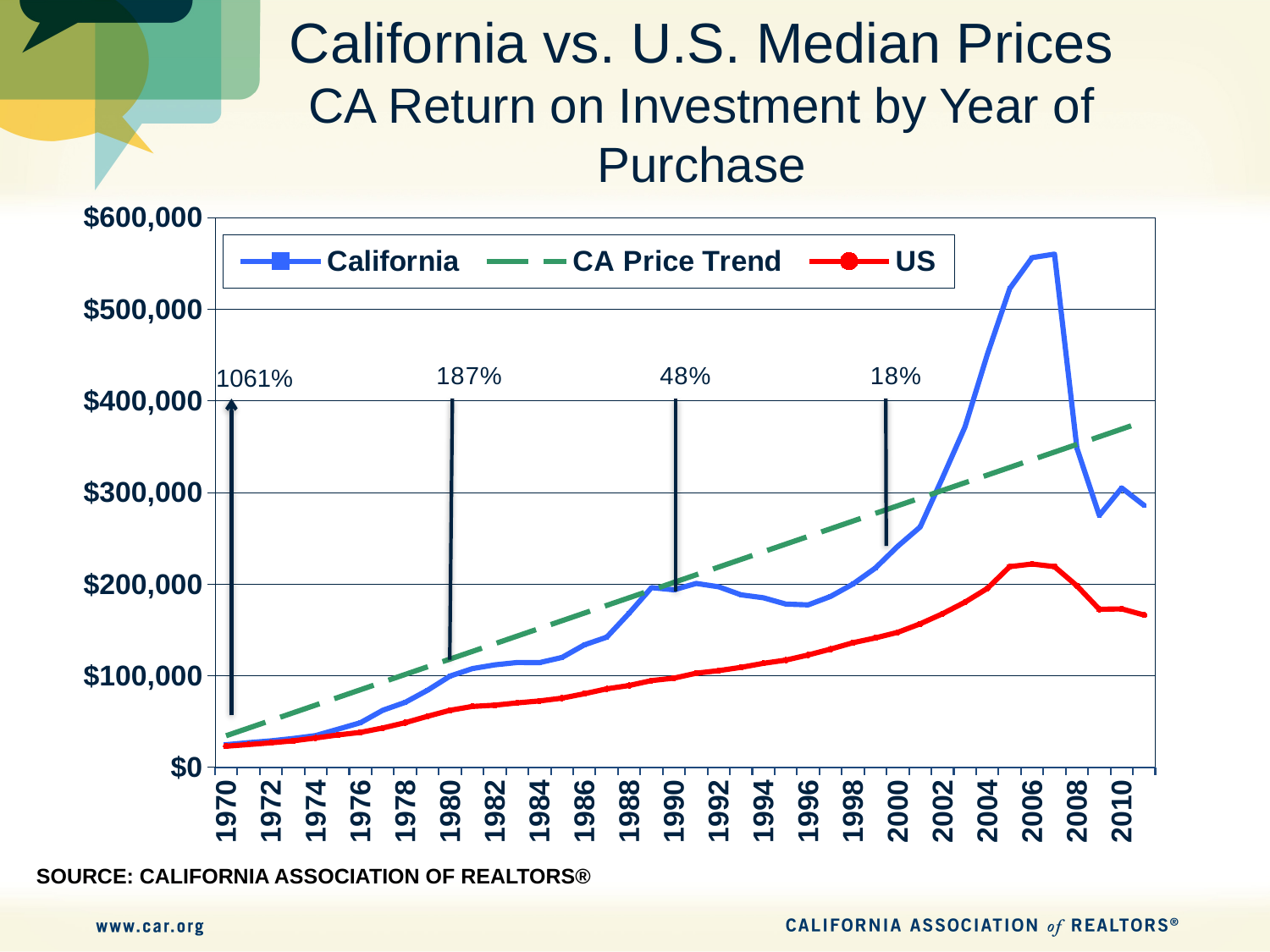
Is the US median price in 2006 greater or less than $300,000? less What kind of chart is shown on the slide? line chart What is the CA return on investment shown for a purchase in 1970? 1061% How many series does the legend list? 3 What is the CA return on investment shown for a purchase in 1990? 48% What are the three series listed in the legend? California, CA Price Trend, US Is the California median price in 2006 greater or less than $500,000? greater What is the CA return on investment shown for a purchase in 2000? 18% What is the CA return on investment shown for a purchase in 1980? 187% Does the US median price line generally rise or fall from 1970 to 2006? rise Which series reaches the highest value on the chart? California In 2006, which is higher, the California median price or the US median price? California